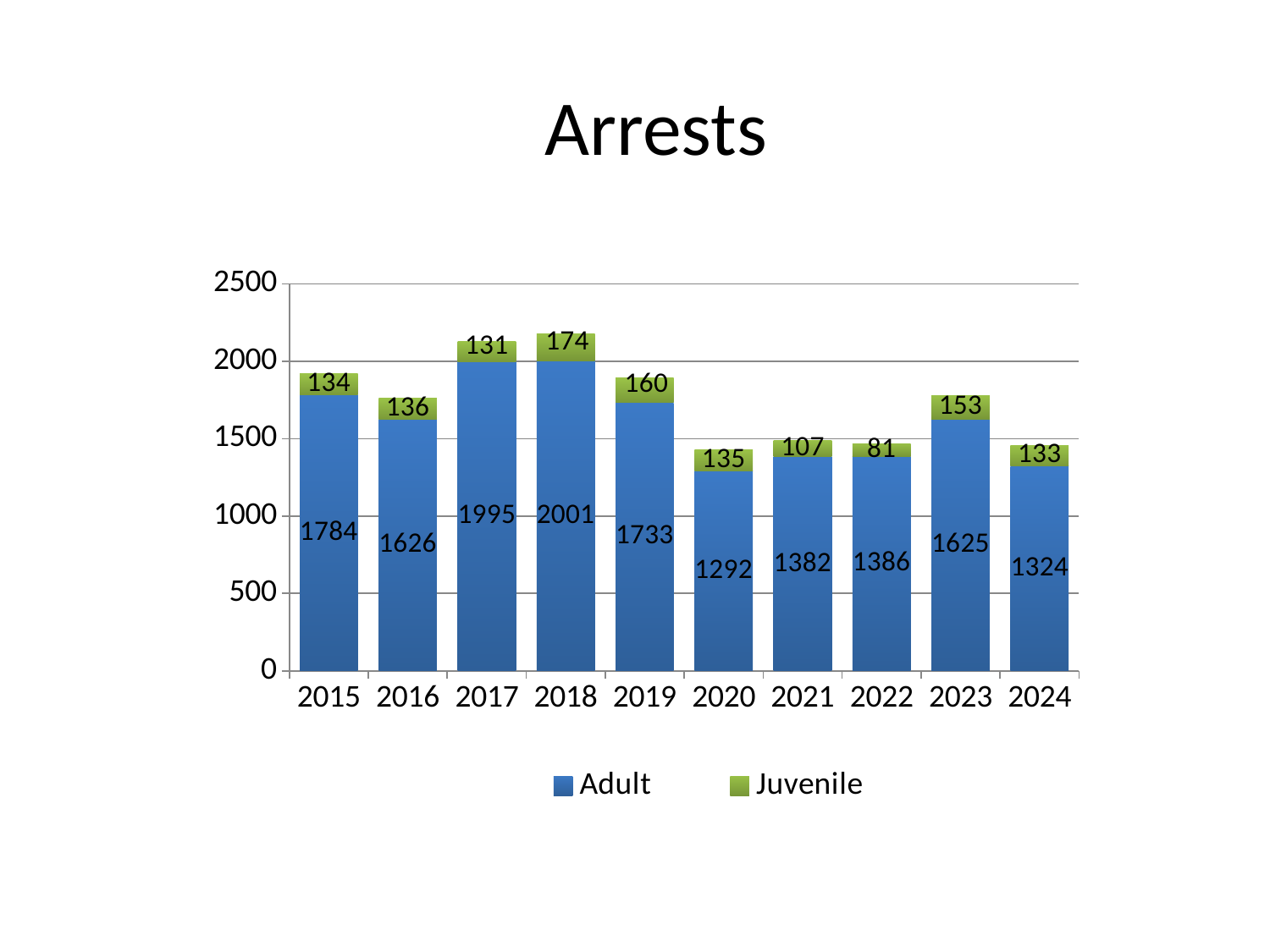
What is the total of the stacked bar for 2024? 1457 Which year has the lowest Adult value? 2020 What is the Adult value for 2018? 2001 What is the Juvenile value for 2022? 81 How many years are shown on the x axis? 10 Which year has the highest Adult value? 2018 Is the total stacked bar for 2018 greater or less than 2000? greater How many series does the legend list? 2 What is the difference between the Adult values for 2017 and 2016? 369 Which year has the lowest Juvenile value? 2022 Which is larger, the Juvenile value for 2019 or for 2023? 2019 What kind of chart is shown? stacked bar chart